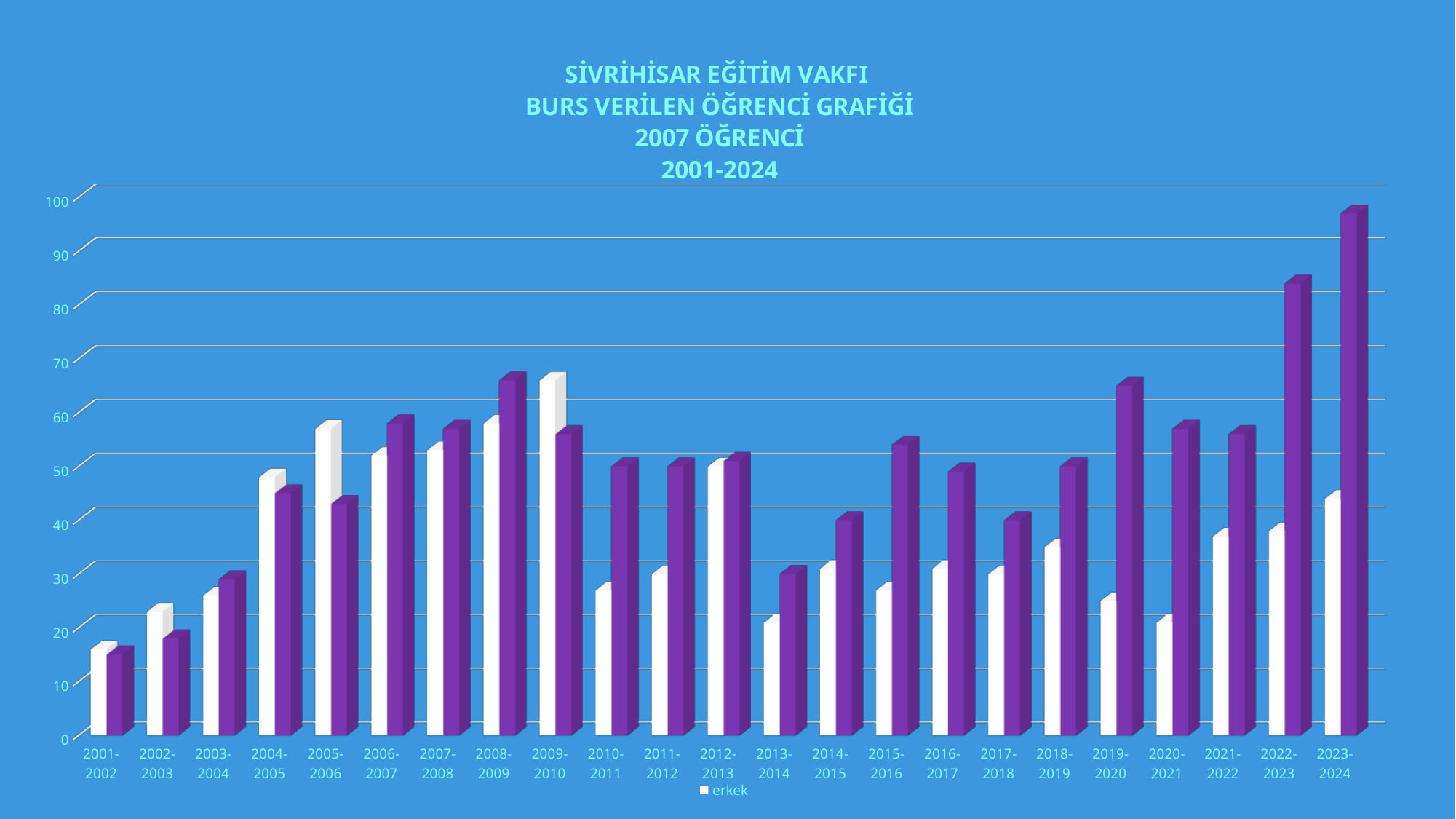
Is the white (erkek) bar for 2001-2002 greater or less than 20? less Is the purple bar for 2022-2023 greater or less than 80? greater Which series entry does the legend list? erkek In which academic year is the purple bar highest? 2023-2024 Is the white (erkek) bar for 2010-2011 greater or less than 30? less What kind of chart is shown on the slide? bar chart In which academic year is the white (erkek) bar lowest? 2001-2002 What colour are the bars for the 'erkek' series? white How many academic-year categories are shown on the x axis? 23 In which academic year is the white (erkek) bar highest? 2009-2010 For 2005-2006, which bar is larger, the white (erkek) bar or the purple bar? the white (erkek) bar